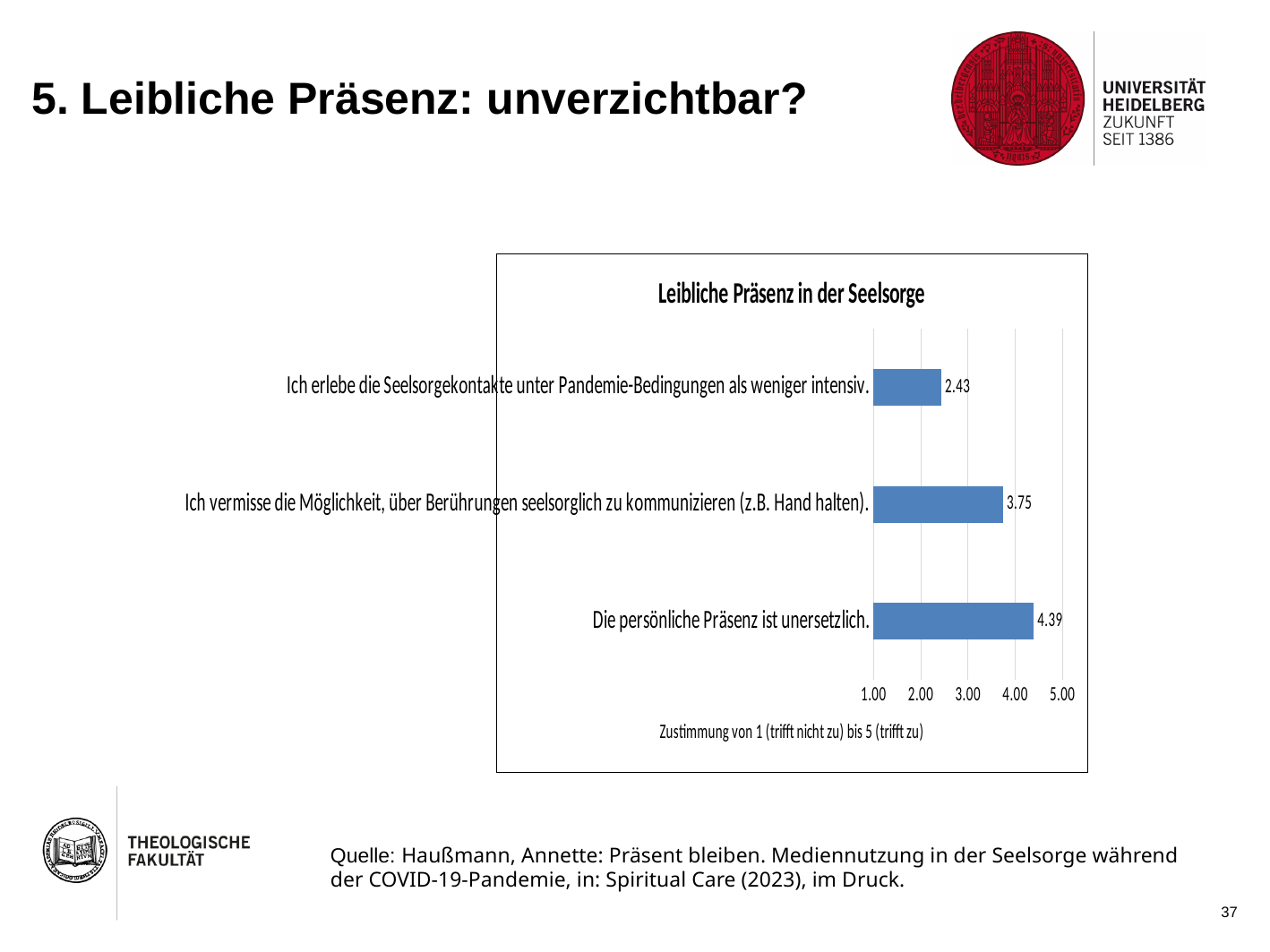
What is the value for "Die persönliche Präsenz ist unersetzlich."? 4.39 How many statements are shown in the chart? 3 What is the value for "Ich erlebe die Seelsorgekontakte unter Pandemie-Bedingungen als weniger intensiv."? 2.43 Which statement has the lowest value? Ich erlebe die Seelsorgekontakte unter Pandemie-Bedingungen als weniger intensiv. What is the value for "Ich vermisse die Möglichkeit, über Berührungen seelsorglich zu kommunizieren (z.B. Hand halten)."? 3.75 Which statement has the highest value? Die persönliche Präsenz ist unersetzlich. What is the difference between the values for "Die persönliche Präsenz ist unersetzlich." and "Ich vermisse die Möglichkeit, über Berührungen seelsorglich zu kommunizieren (z.B. Hand halten)."? 0.64 What is the difference between the values for "Die persönliche Präsenz ist unersetzlich." and "Ich erlebe die Seelsorgekontakte unter Pandemie-Bedingungen als weniger intensiv."? 1.96 Is the value for "Die persönliche Präsenz ist unersetzlich." greater or less than 4.00? greater What is the title of the chart? Leibliche Präsenz in der Seelsorge What kind of chart is shown on the slide? bar chart Which is larger: the value for "Ich vermisse die Möglichkeit, über Berührungen seelsorglich zu kommunizieren (z.B. Hand halten)." or for "Ich erlebe die Seelsorgekontakte unter Pandemie-Bedingungen als weniger intensiv."? Ich vermisse die Möglichkeit, über Berührungen seelsorglich zu kommunizieren (z.B. Hand halten).